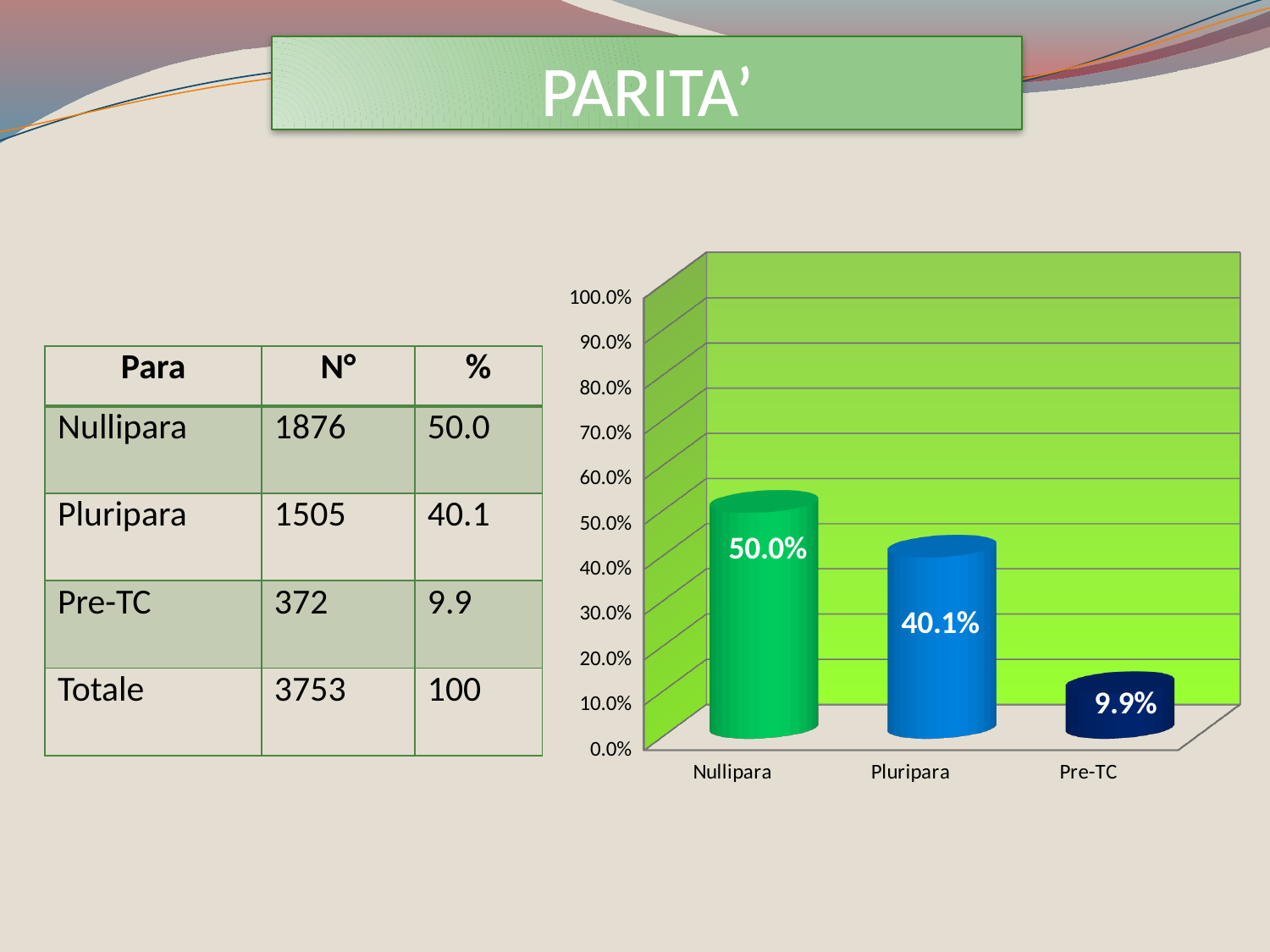
What is the value shown for Pluripara in the chart? 40.1% Which category has the highest value in the chart? Nullipara What kind of chart is shown on the slide? bar chart Which is larger, the value for Pluripara or the value for Pre-TC? Pluripara How many categories are shown on the x axis of the chart? 3 Which category has the lowest value in the chart? Pre-TC What is the value shown for Pre-TC in the chart? 9.9% What is the difference between the values for Nullipara and Pluripara? 9.9% Do the values rise or fall from left to right along the x axis? fall Is the value for Pre-TC greater or less than 20.0%? less What is the value shown for Nullipara in the chart? 50.0% What is the difference between the values for Pluripara and Pre-TC? 30.2%